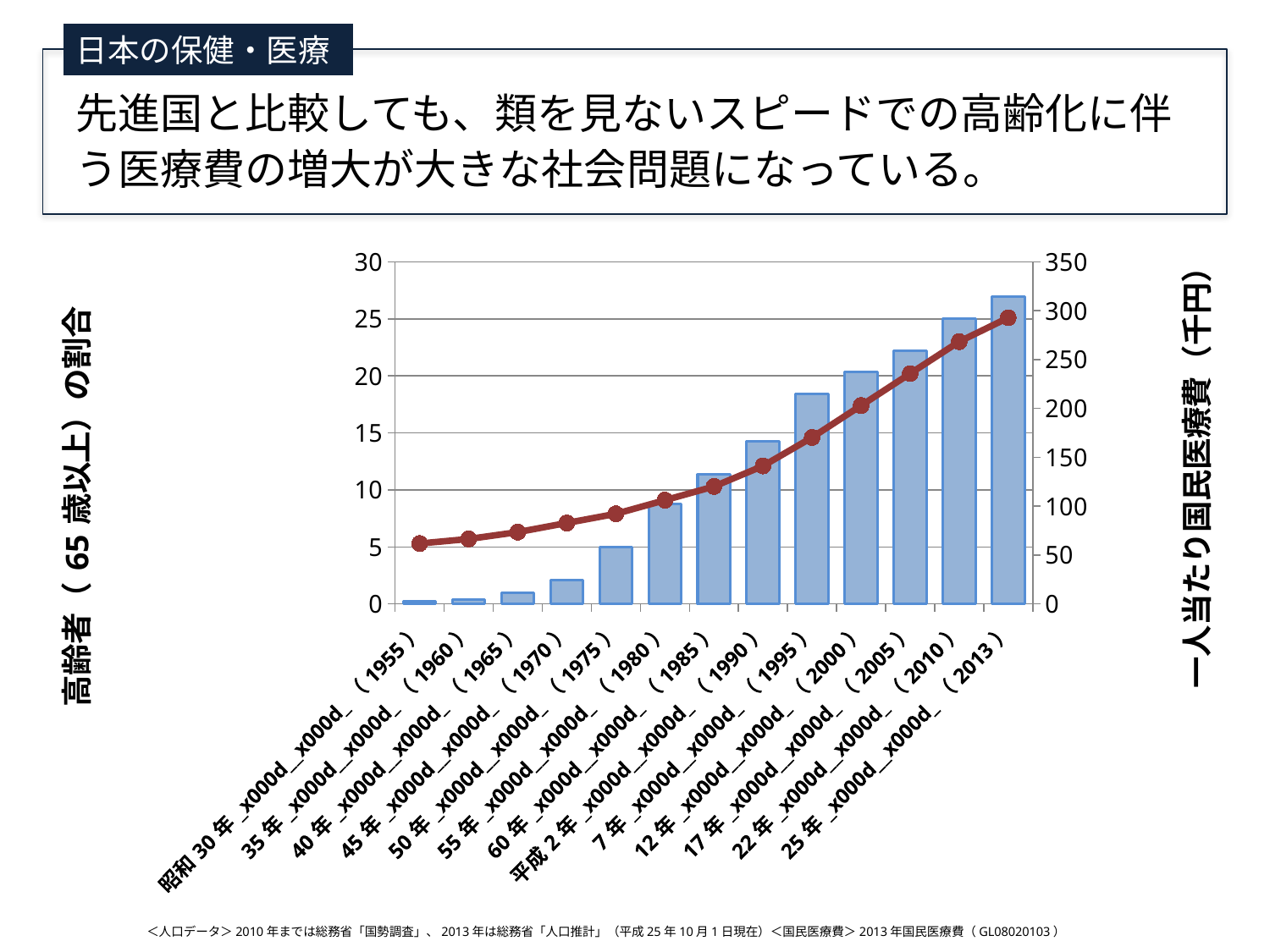
What kind of chart is shown on the slide? A combination bar and line chart How many year categories are shown on the x axis of the chart? 13 Which year has the shortest bar in the chart? 1955 (昭和30年) What is the title of the right-hand vertical axis of the chart? 一人当たり国民医療費（千円） Do the bar values rise or fall from 1955 to 2013? Rise Does the line series rise or fall from 1955 to 2013? Rise Is the bar value for 2013 on the right axis greater or less than 300? greater Which year has the tallest bar in the chart? 2013 (平成25年) Which bar is taller, 1995 or 2005? 2005 Is the bar value for 1975 on the right axis greater or less than 100? less Is the bar value for 2000 on the right axis greater or less than 200? greater